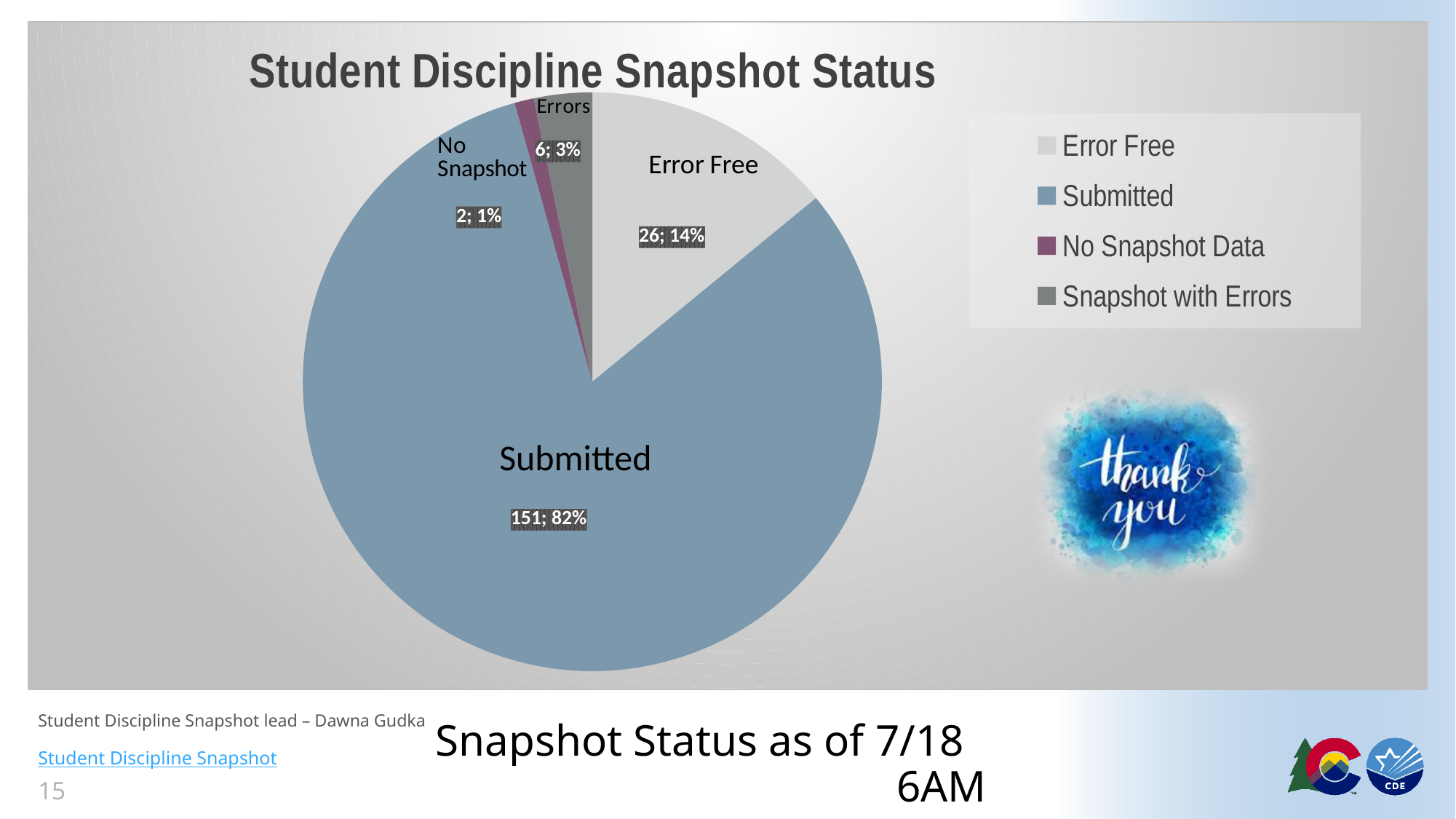
Which category has the smallest slice? No Snapshot Data What share of the pie does the Error Free slice represent? 14% What is the title of the chart? Student Discipline Snapshot Status What is the count for the Error Free slice? 26 What is the count for the Snapshot with Errors slice? 6 Which category has the largest slice? Submitted How many categories does the legend list? 4 What is the count for the No Snapshot Data slice? 2 What is the difference between the Submitted count and the Error Free count? 125 What type of chart is shown on the slide? Pie chart What is the count for the Submitted slice? 151 What share of the pie does the Submitted slice represent? 82%